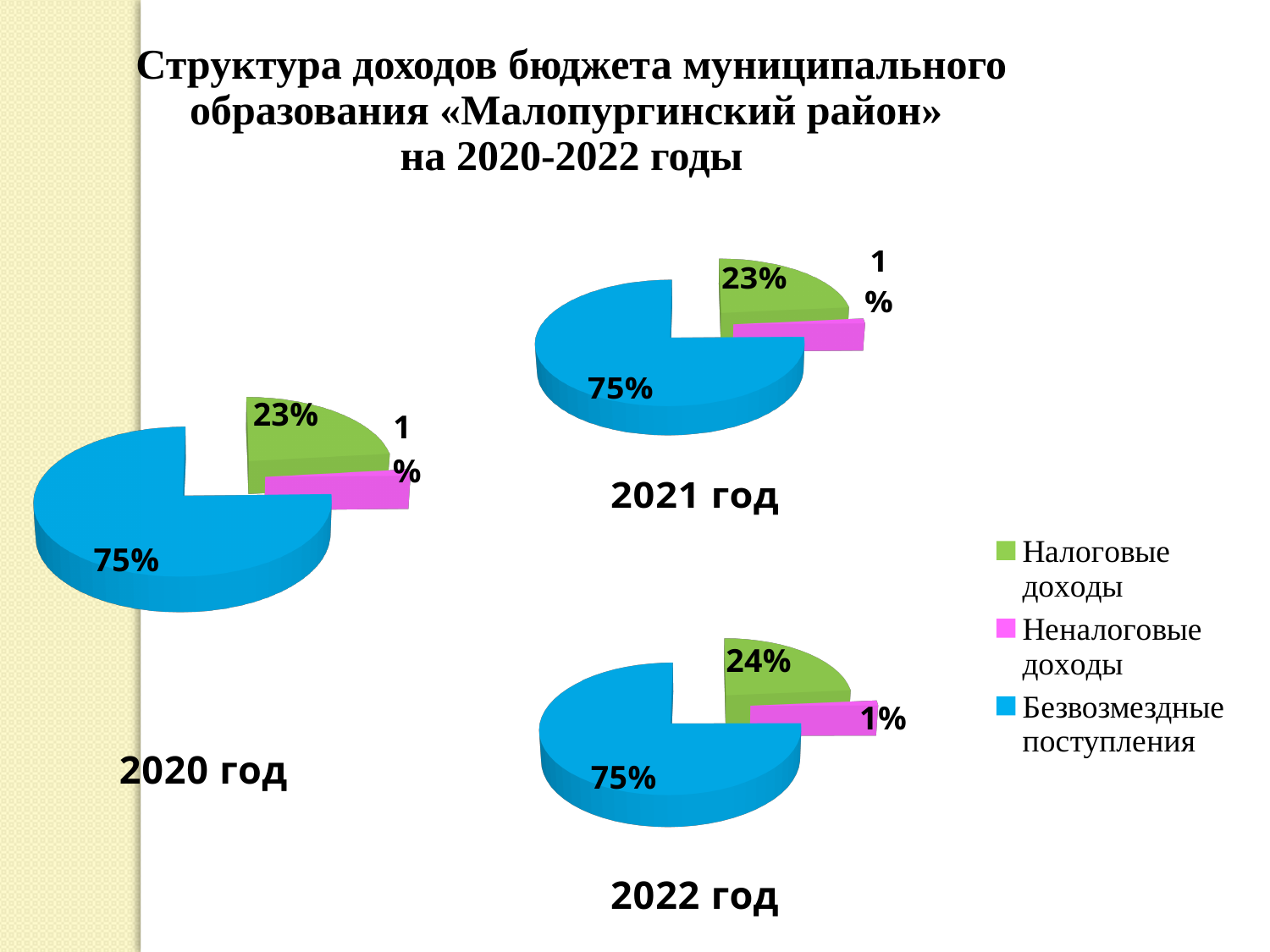
In the 2022 год pie chart, what is the difference between the shares of Безвозмездные поступления and Налоговые доходы? 51% In the 2021 год pie chart, what share is labelled for Неналоговые доходы? 1% In the 2022 год pie chart, what share is labelled for Налоговые доходы? 24% What kind of chart is used for 2020 год? Pie chart How many series does the legend list? 3 In the 2020 год pie chart, what share is labelled for Налоговые доходы? 23% In the 2021 год pie chart, which category has the smallest slice? Неналоговые доходы Which colour represents Неналоговые доходы in the legend? Pink In the 2022 год pie chart, which category has the largest slice? Безвозмездные поступления How many slices does the 2021 год pie chart have? 3 In the 2020 год pie chart, which is larger: Налоговые доходы or Неналоговые доходы? Налоговые доходы In the 2020 год pie chart, what share is labelled for Безвозмездные поступления? 75%